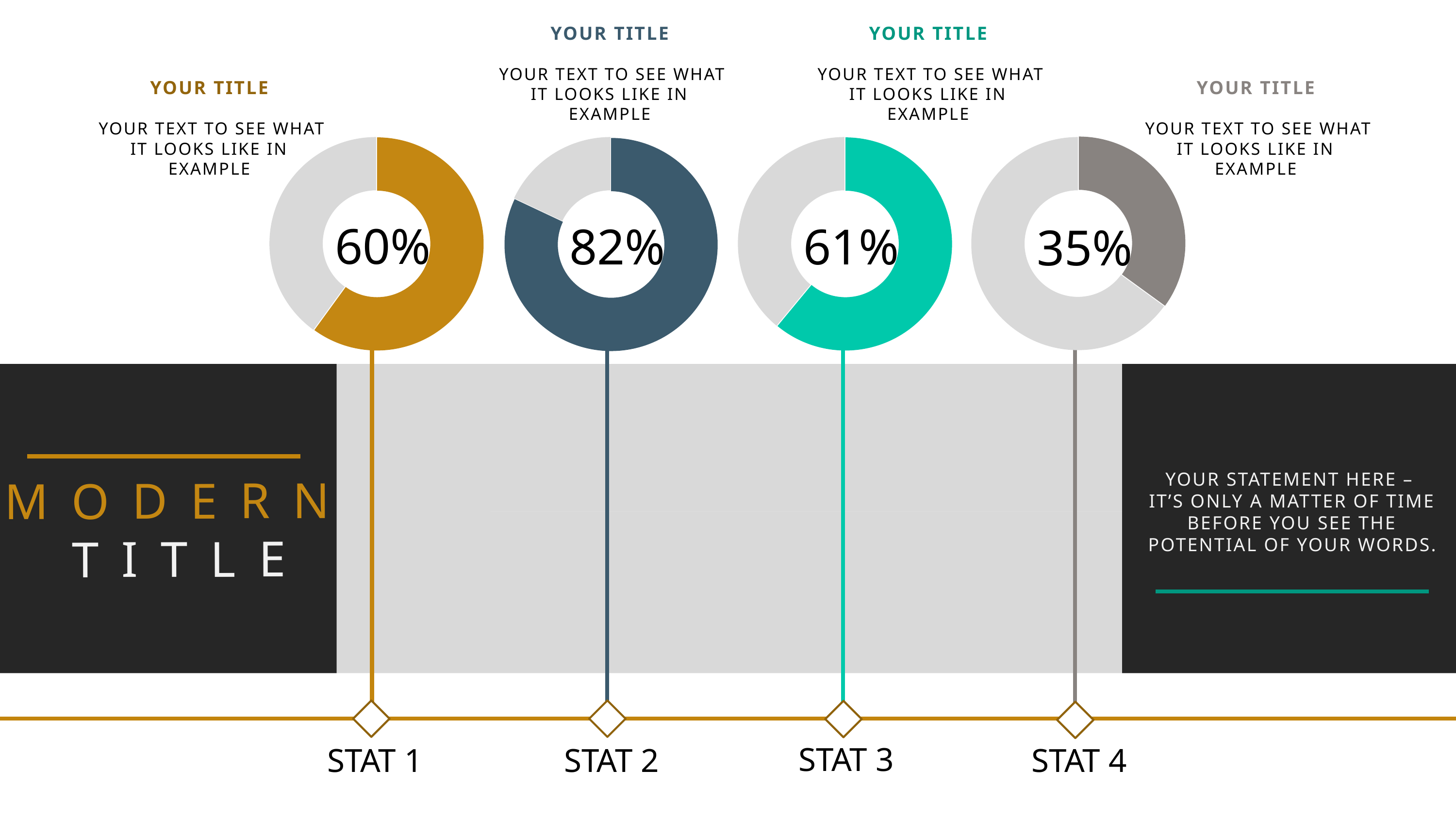
What is the difference between the percentage shown for STAT 3 and the percentage shown for STAT 1? 1% What value is shown in the donut chart above STAT 3? 61% What value is shown in the donut chart above STAT 2? 82% Which of the four stats (STAT 1 to STAT 4) has the lowest percentage shown in its donut chart? STAT 4 What is the difference between the percentage shown for STAT 2 and the percentage shown for STAT 4? 47% How many donut charts are shown on the slide? 4 Which of the four stats (STAT 1 to STAT 4) has the highest percentage shown in its donut chart? STAT 2 What kind of chart is used to display the value above STAT 2? Donut chart What value is shown in the donut chart above STAT 4? 35% What colour is the filled segment of the donut chart above STAT 3? Teal What value is shown in the donut chart above STAT 1? 60% Which is larger, the percentage shown for STAT 1 or the percentage shown for STAT 4? STAT 1